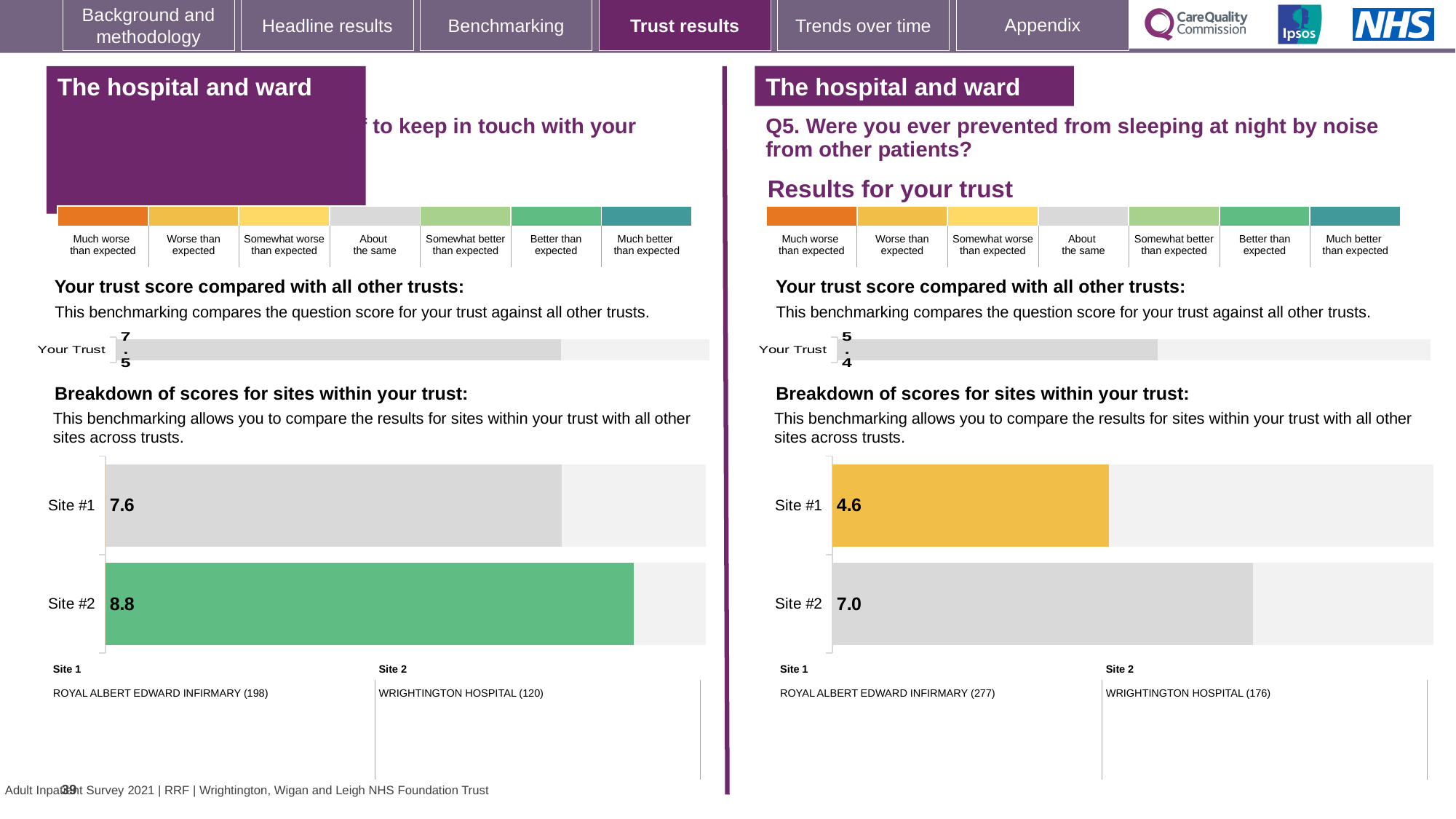
On the left-hand 'Breakdown of scores for sites within your trust' chart, what is the score for Site #1? 7.6 On the Q5 site breakdown chart, what is the difference between the Site #2 and Site #1 scores? 2.4 On the left-hand 'Your trust score compared with all other trusts' chart, what is the score for Your Trust? 7.5 On the Q5 'Breakdown of scores for sites within your trust' chart, what is the score for Site #1? 4.6 On the left-hand 'Breakdown of scores for sites within your trust' chart, what is the score for Site #2? 8.8 On the left-hand site breakdown chart, which site has the lower score? Site #1 What type of chart is used for the Q5 site breakdown? Bar chart How many sites are shown on the Q5 site breakdown chart? 2 On the Q5 'Your trust score compared with all other trusts' chart, what is the score for Your Trust? 5.4 On the Q5 site breakdown chart, which site has the higher score? Site #2 On the Q5 'Breakdown of scores for sites within your trust' chart, what is the score for Site #2? 7.0 On the left-hand site breakdown chart, what is the difference between the Site #2 and Site #1 scores? 1.2